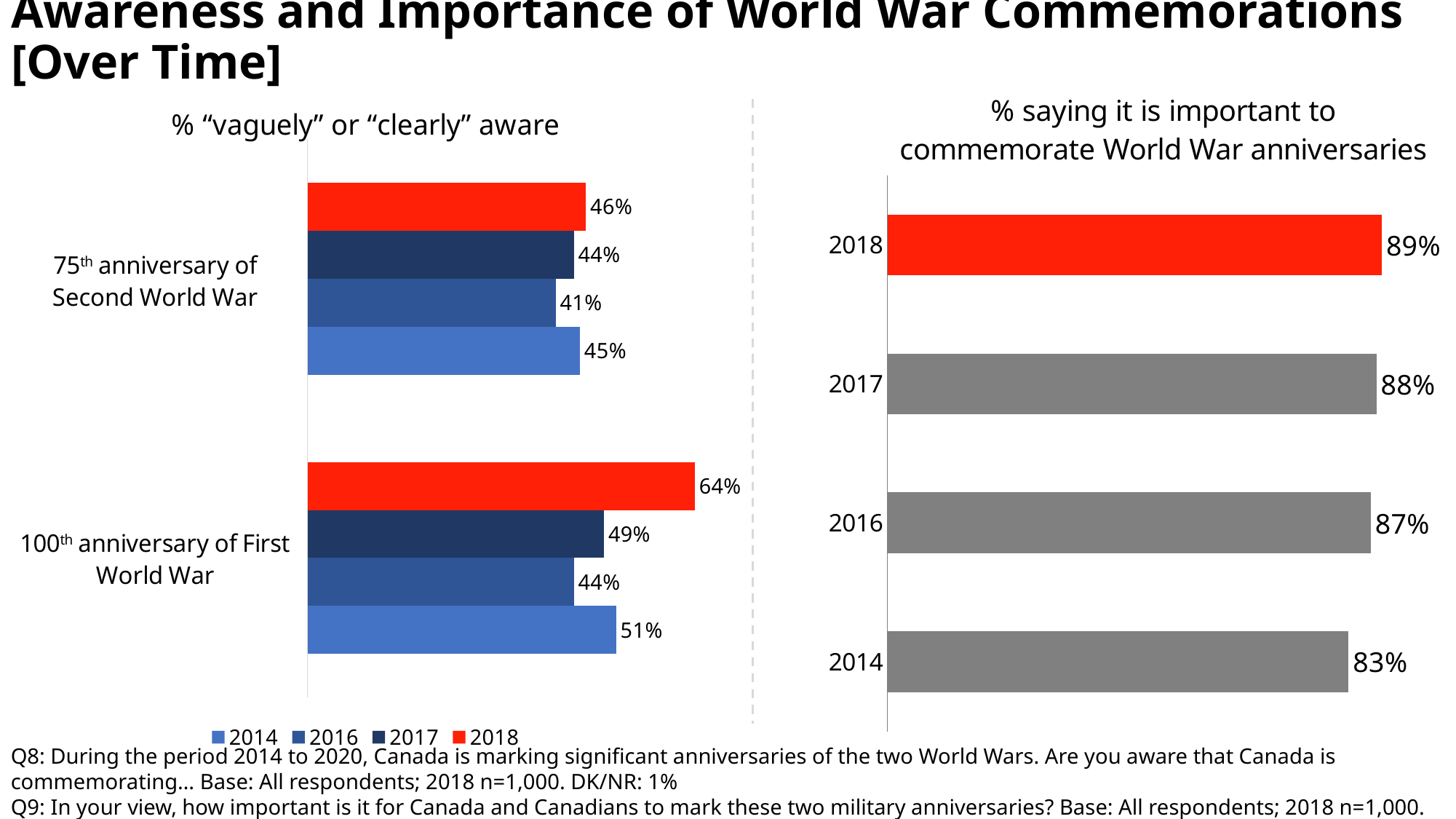
How many years are shown in the right chart (% saying it is important to commemorate World War anniversaries)? 4 How many series does the legend of the left chart (% "vaguely" or "clearly" aware) list? 4 What kind of chart is the right chart (% saying it is important to commemorate World War anniversaries)? Bar chart In the right chart (% saying it is important to commemorate World War anniversaries), what is the value for 2014? 83% In the left chart (% "vaguely" or "clearly" aware), what is the difference between the 2018 and 2017 values for the 100th anniversary of First World War? 15 percentage points In the right chart (% saying it is important to commemorate World War anniversaries), which year has the lowest value? 2014 In the left chart (% "vaguely" or "clearly" aware), what is the 2018 value for the 100th anniversary of First World War? 64% In the left chart (% "vaguely" or "clearly" aware), what is the 2016 value for the 75th anniversary of Second World War? 41% In the right chart (% saying it is important to commemorate World War anniversaries), which year's bar is coloured red? 2018 In the right chart (% saying it is important to commemorate World War anniversaries), which year has the highest value? 2018 In the right chart (% saying it is important to commemorate World War anniversaries), what is the difference between the 2018 and 2014 values? 6 percentage points In the left chart (% "vaguely" or "clearly" aware), which is larger for the 75th anniversary of Second World War: the 2014 value or the 2016 value? 2014